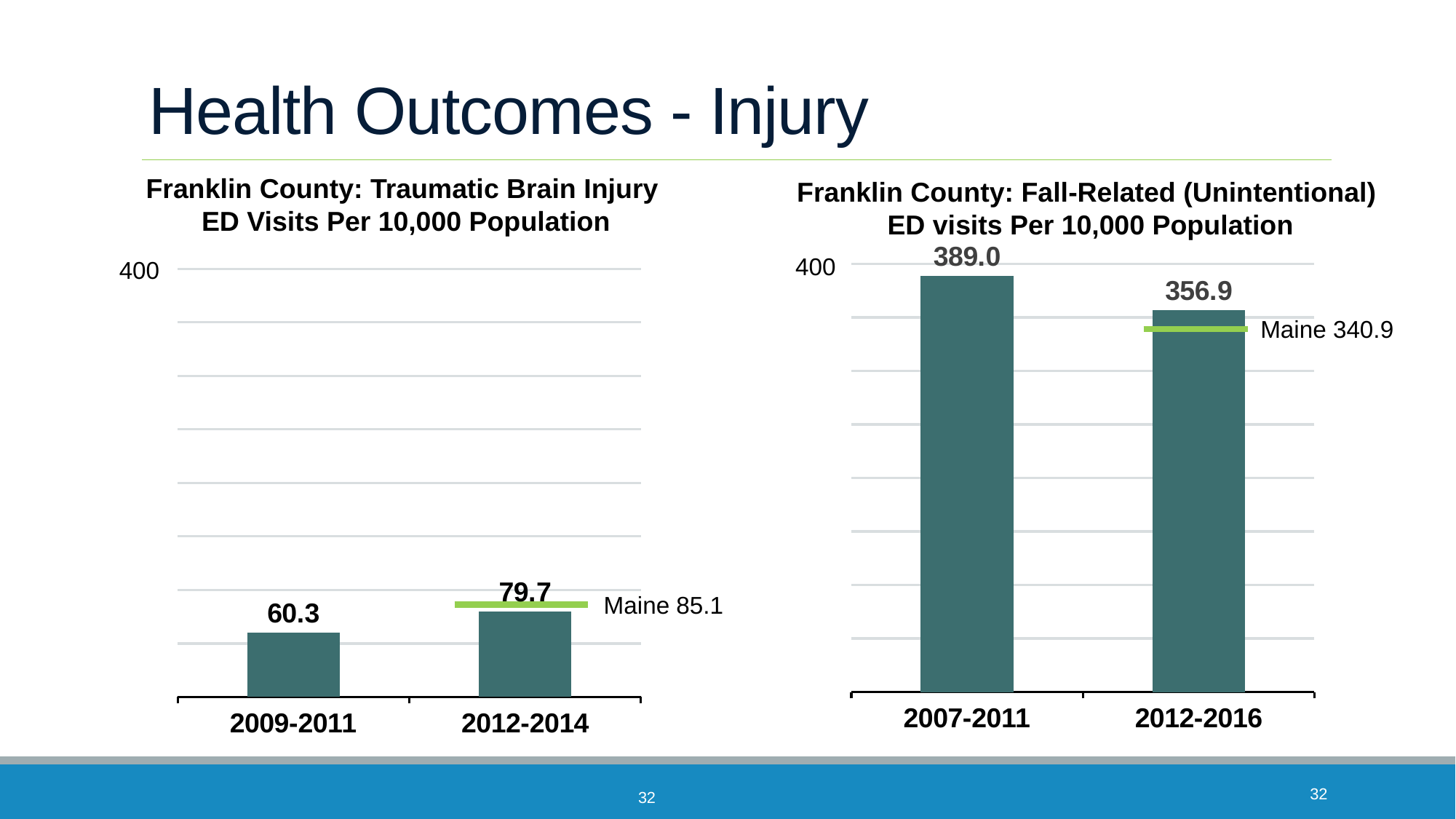
In the Fall-Related (Unintentional) chart, what is the difference between the 2007-2011 and 2012-2016 values? 32.1 In the Fall-Related (Unintentional) chart, which period has the lower value? 2012-2016 In the Traumatic Brain Injury chart, which period has the higher value? 2012-2014 In the Traumatic Brain Injury chart, do the values rise or fall from 2009-2011 to 2012-2014? rise In the Traumatic Brain Injury chart, what is the value for 2012-2014? 79.7 In the Fall-Related (Unintentional) chart, what is the value for 2012-2016? 356.9 In the Traumatic Brain Injury chart, what is the difference between the 2012-2014 and 2009-2011 values? 19.4 In the Traumatic Brain Injury chart, what is the Maine value shown by the green line? 85.1 In the Fall-Related (Unintentional) chart, what is the Maine value shown by the green line? 340.9 In the Traumatic Brain Injury chart, what is the value for 2009-2011? 60.3 In the Fall-Related (Unintentional) chart, what is the value for 2007-2011? 389.0 What kind of chart is the Fall-Related (Unintentional) chart? bar chart